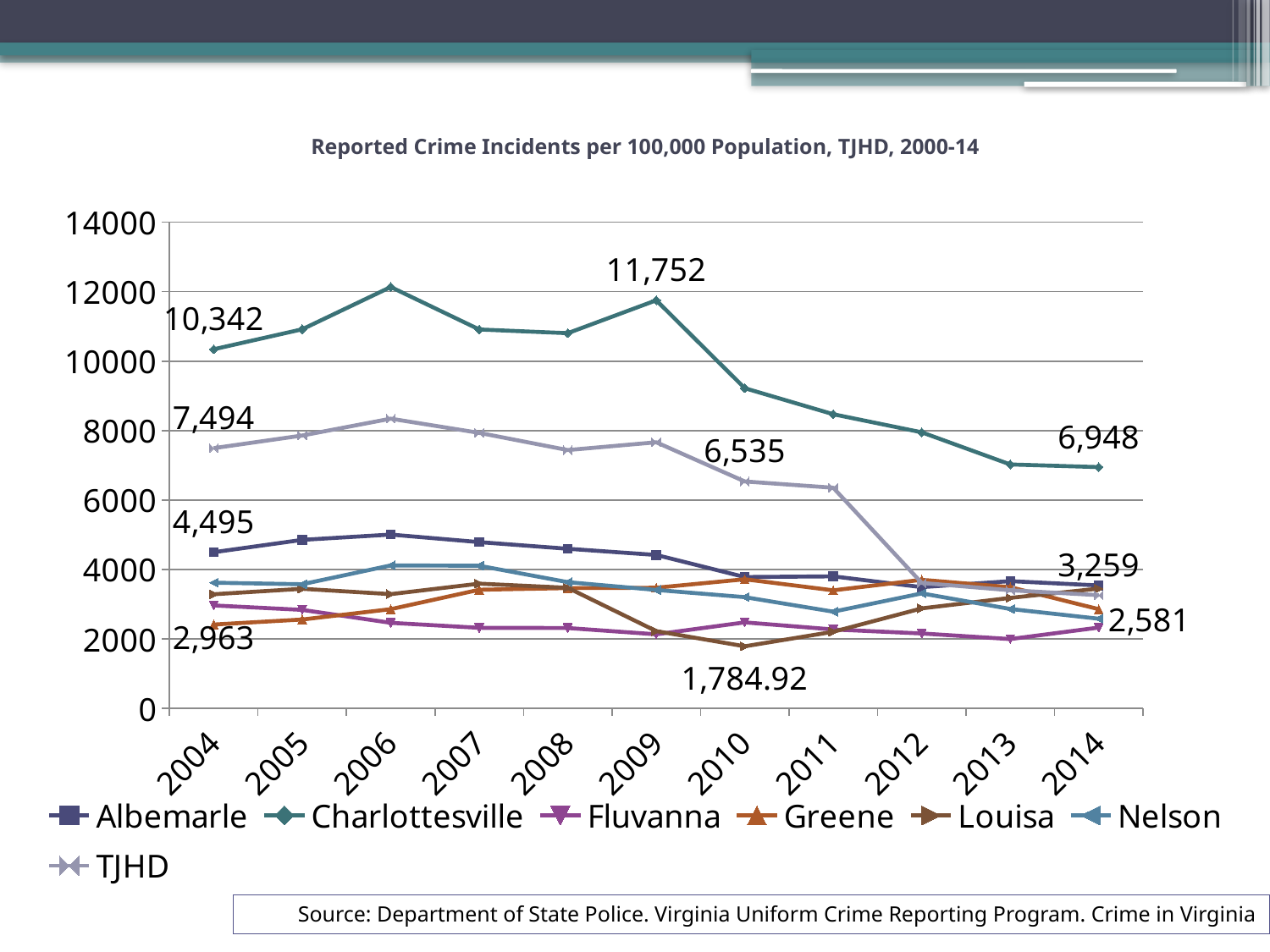
What is the value for Charlottesville in 2009? 11,752 By how much did the Charlottesville value fall from 2009 to 2014? 4,804 What is the value for Louisa in 2010? 1,784.92 What is the value for TJHD in 2004? 7,494 What kind of chart is shown on the slide? Line chart What is the value for Charlottesville in 2004? 10,342 Which series has the lowest value in 2010? Louisa What is the value for Albemarle in 2004? 4,495 How many series does the legend list? 7 Which series has the highest value in 2009? Charlottesville Is the value for TJHD in 2006 greater or less than 8000? greater What is the value for Charlottesville in 2014? 6,948